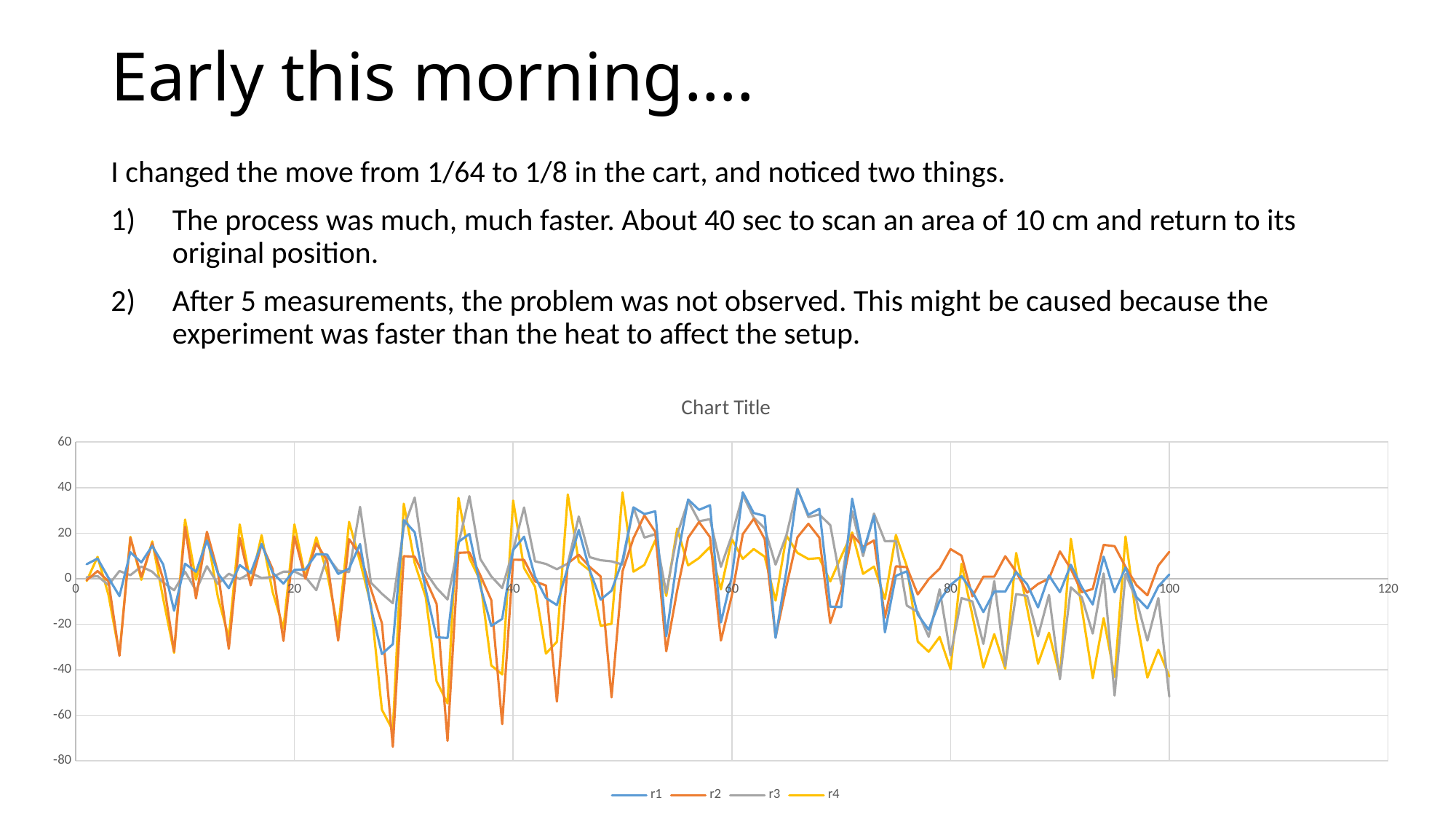
Between x = 80 and x = 100, do the values of r4 lie mostly above or below 0? below Is the highest value for r1 greater or less than 20? greater How many series does the chart legend list? 4 Is the lowest value for r2 greater or less than -60? less Is the lowest value for r1 greater or less than -40? greater What kind of chart is shown on the slide? line chart Which series reaches the lowest value on the chart? r2 What are the names of the series listed in the chart legend? r1, r2, r3, r4 What is the title of the chart? Chart Title